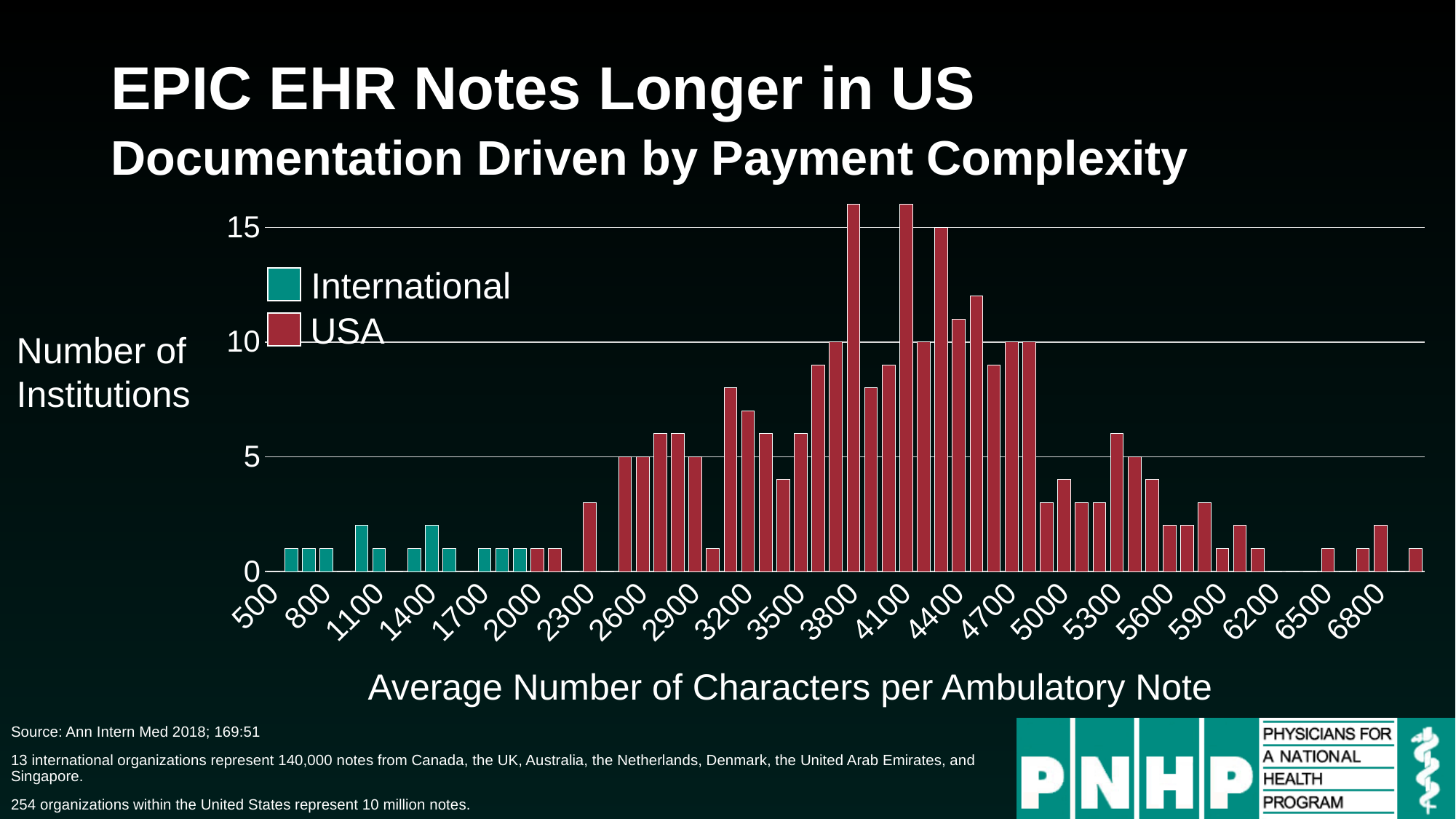
Do the USA bars generally rise or fall as the character count increases from 2300 toward 3800? rise Is the tallest International bar greater or less than 5? less What is the highest value shown on the y axis? 15 Which series has the tallest bars, International or USA? USA Which series has its bars at the lower end of the character-count axis, International or USA? International Do the USA bars generally rise or fall as the character count increases from 4400 toward 6800? fall What is the label on the x axis of the chart? Average Number of Characters per Ambulatory Note How many series does the legend list? 2 What kind of chart is shown on the slide? Bar chart Is the tallest USA bar greater or less than 15? greater What are the two series named in the legend? International and USA How many tick labels are shown along the x axis? 22